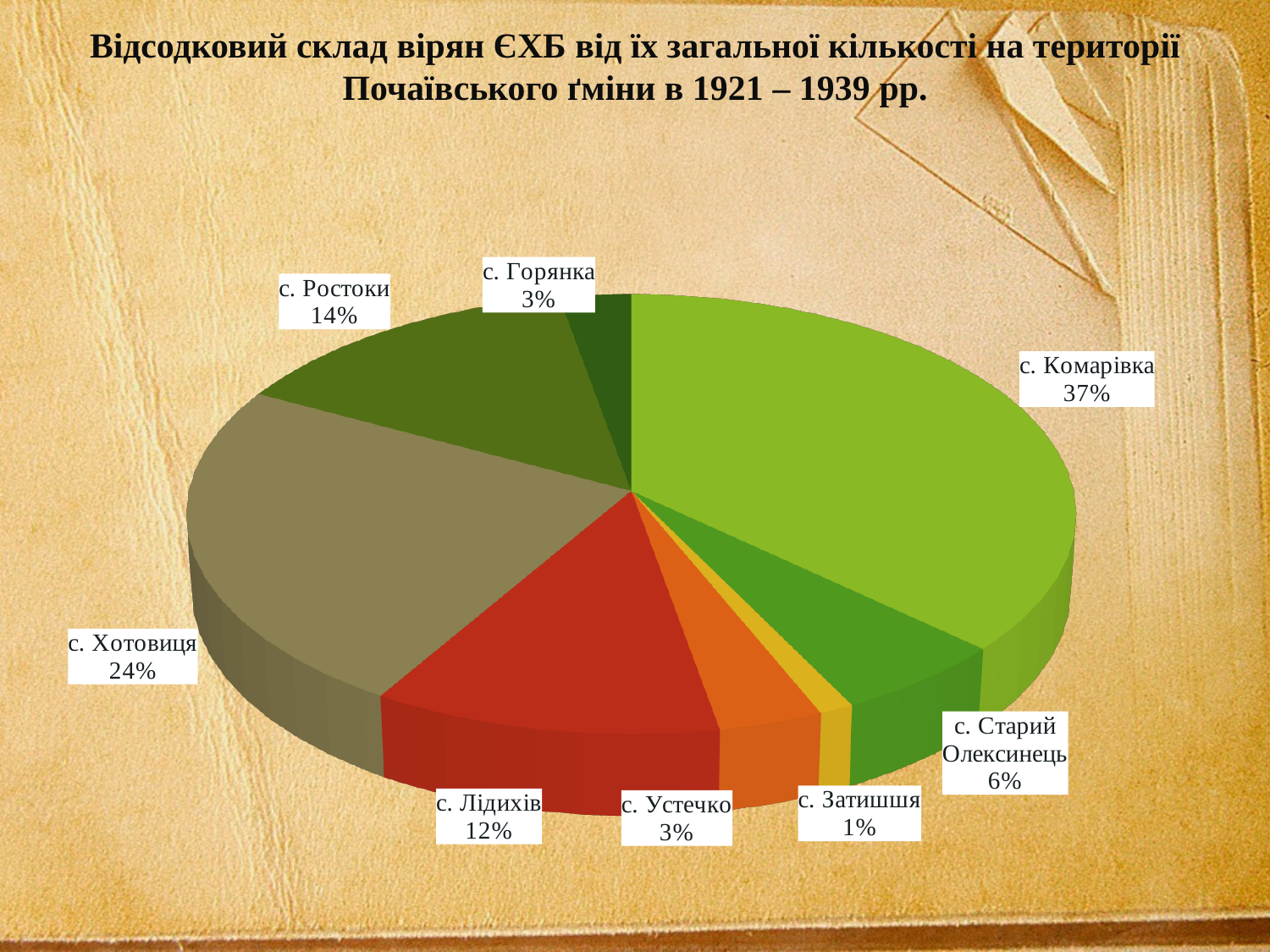
Which two villages each have a share of 3%? с. Горянка and с. Устечко What kind of chart is shown on the slide? pie chart What is the difference between the shares of с. Комарівка and с. Хотовиця? 13% Which village has the largest slice of the pie? с. Комарівка Which village has the smallest slice of the pie? с. Затишшя What is the value shown for с. Старий Олексинець? 6% What is the value shown for с. Лідихів? 12% What share of the pie does с. Хотовиця have? 24% What is the difference between the shares of с. Хотовиця and с. Ростоки? 10% What share of the pie does с. Комарівка have? 37% How many slices does the pie chart have? 8 Which is larger, the share of с. Ростоки or the share of с. Лідихів? с. Ростоки